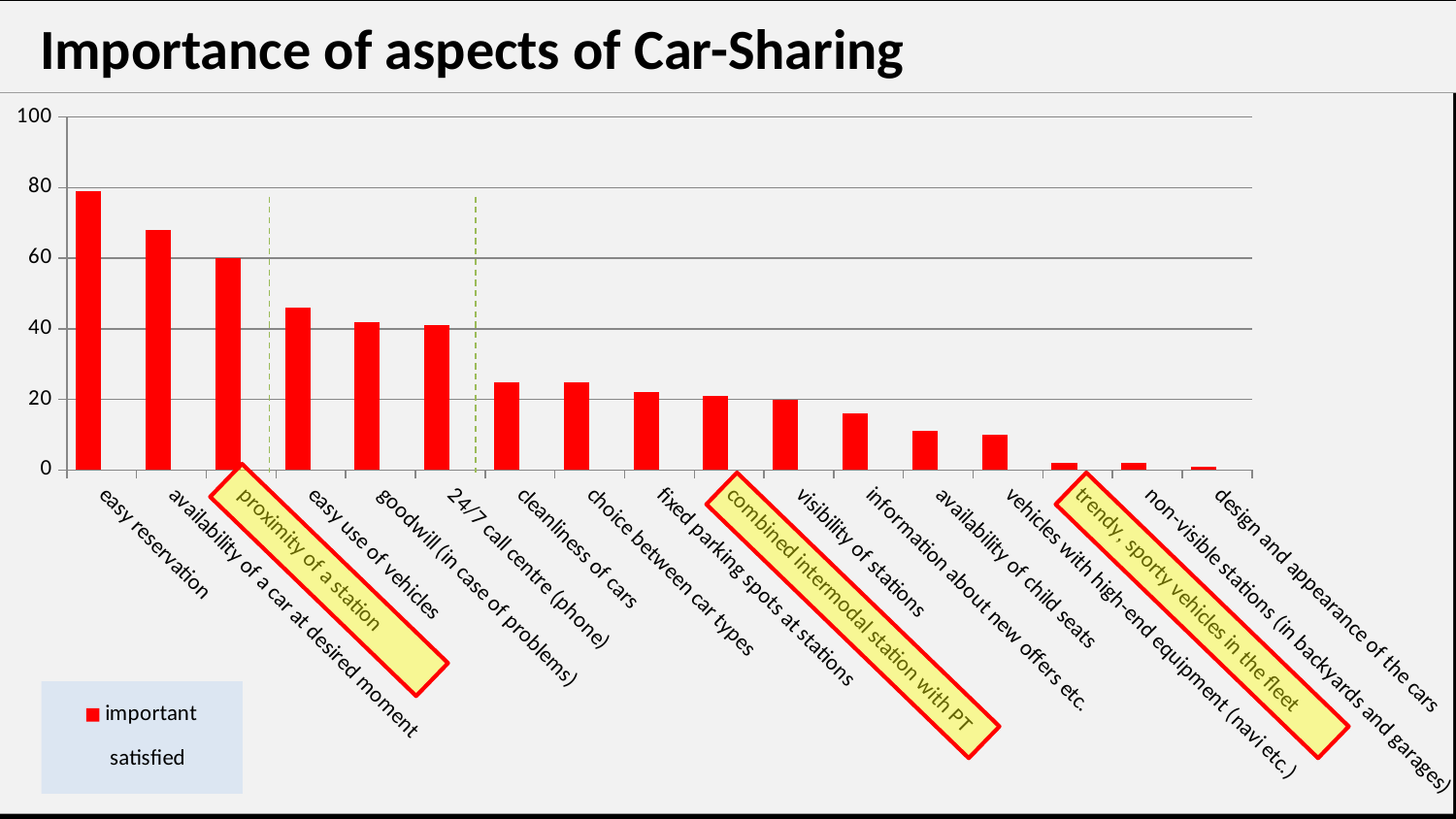
Which aspect has the highest bar? easy reservation How many entries does the legend list? 2 Is the value for information about new offers etc. greater or less than 20? less Which is larger, the value for proximity of a station or the value for availability of child seats? proximity of a station Which is larger, the value for easy reservation or the value for cleanliness of cars? easy reservation Is the value for easy use of vehicles greater or less than 40? greater Is the value for availability of a car at desired moment greater or less than 80? less How many categories are plotted on the x axis? 17 What kind of chart is shown on the slide? bar chart Do the bar values rise or fall from left to right along the x axis? fall What is the title of the chart? Importance of aspects of Car-Sharing